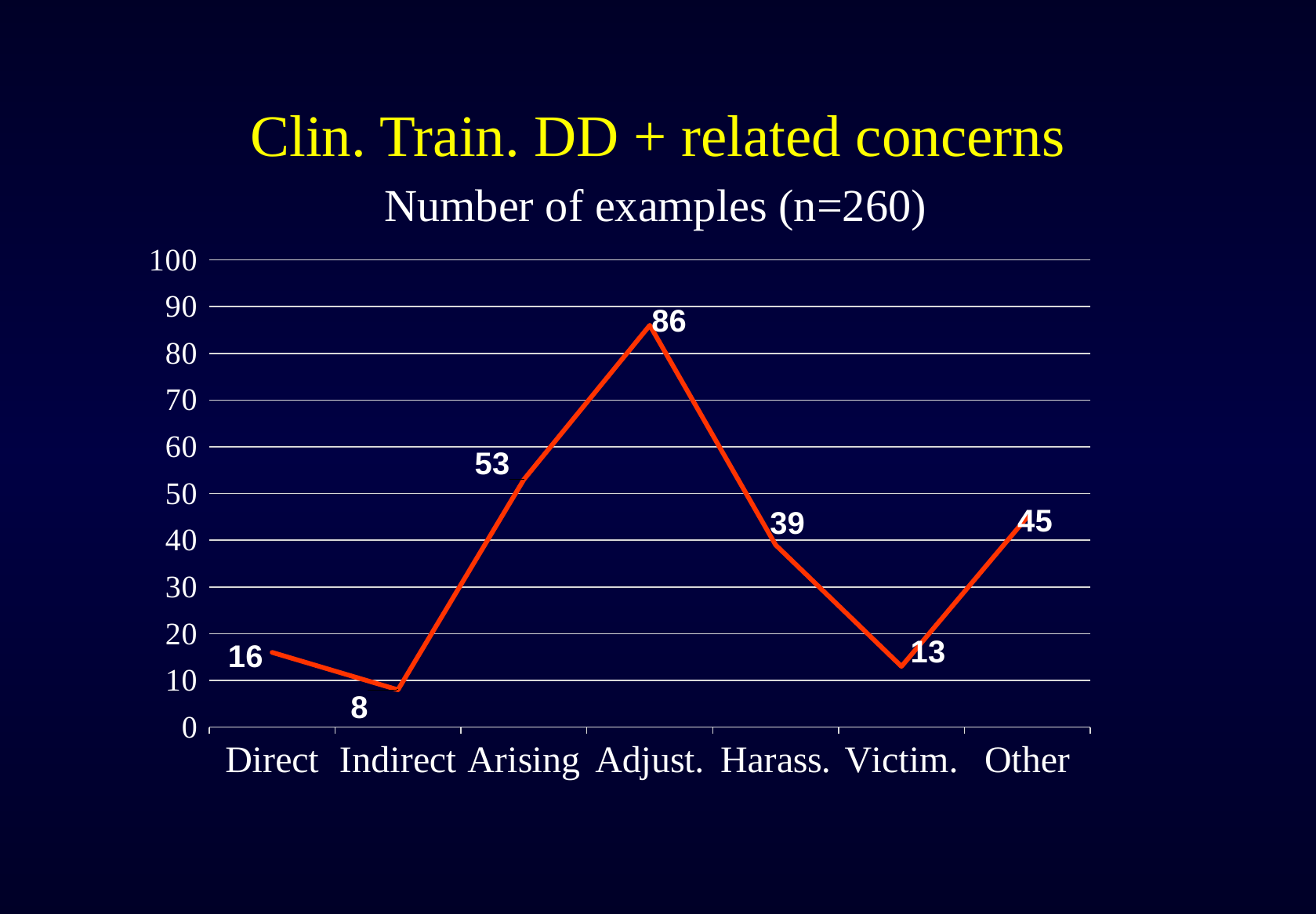
What is the value for Other? 45 Does the value rise or fall from Direct to Indirect? fall Which category has the lowest value? Indirect How many categories are shown on the x axis? 7 Which is larger, the value for Harass. or the value for Other? Other Which category has the highest value? Adjust. What is the value for Adjust.? 86 What kind of chart is shown on the slide? line chart What is the value for Indirect? 8 What is the difference between the values for Adjust. and Arising? 33 Is the value for Arising greater or less than 50? greater